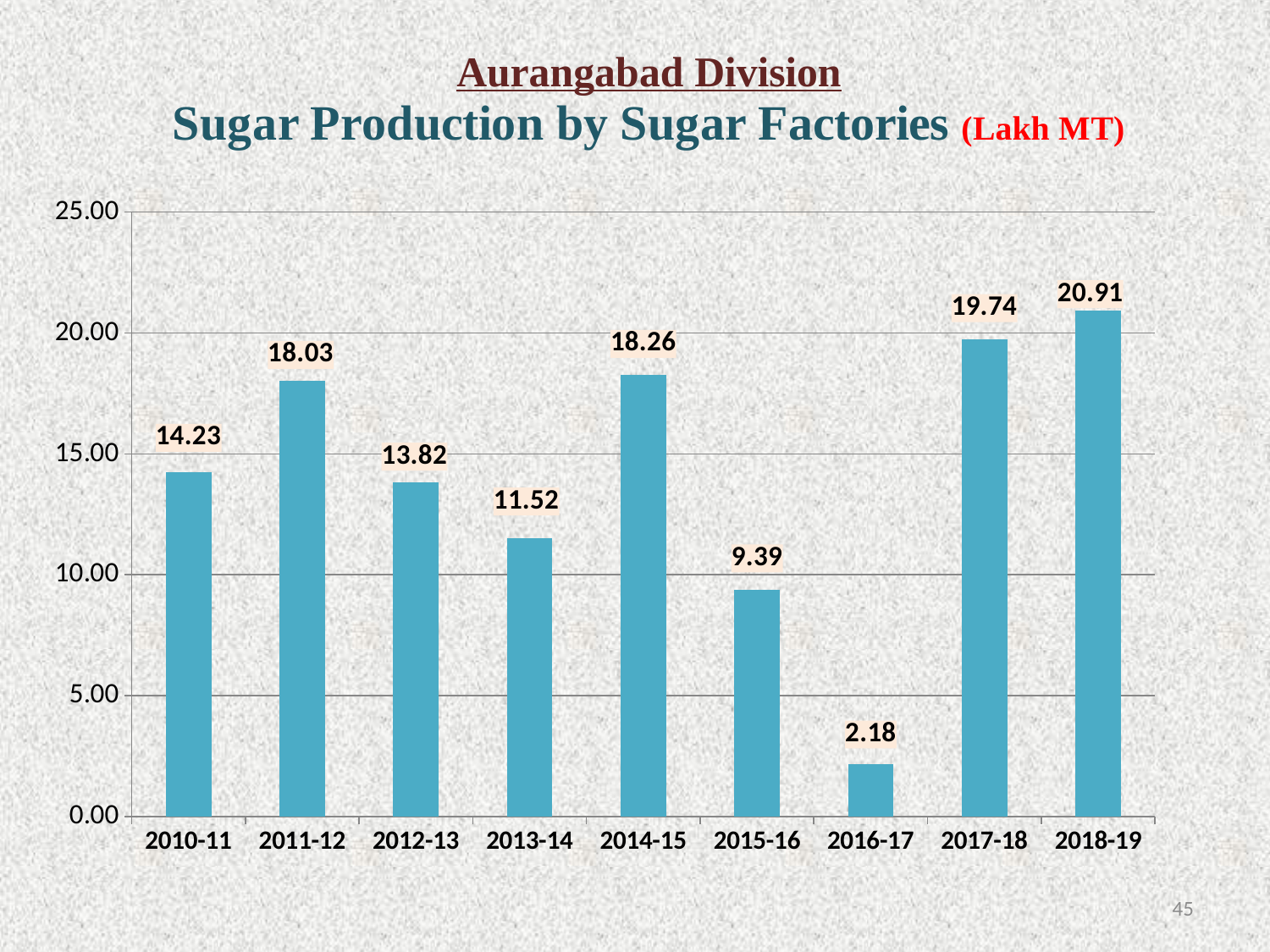
How many years are shown on the chart? 9 Which year had higher sugar production, 2012-13 or 2013-14? 2012-13 What is the difference in sugar production between 2018-19 and 2017-18? 1.17 Did sugar production rise or fall from 2016-17 to 2018-19? rise What was the sugar production in 2014-15? 18.26 What kind of chart is shown on the slide? bar chart Is the value for 2015-16 greater or less than 10.00? less What was the sugar production in 2016-17? 2.18 What is the difference in sugar production between 2011-12 and 2010-11? 3.80 Which year had the highest sugar production? 2018-19 Which year had the lowest sugar production? 2016-17 In what unit is sugar production shown on the chart? Lakh MT